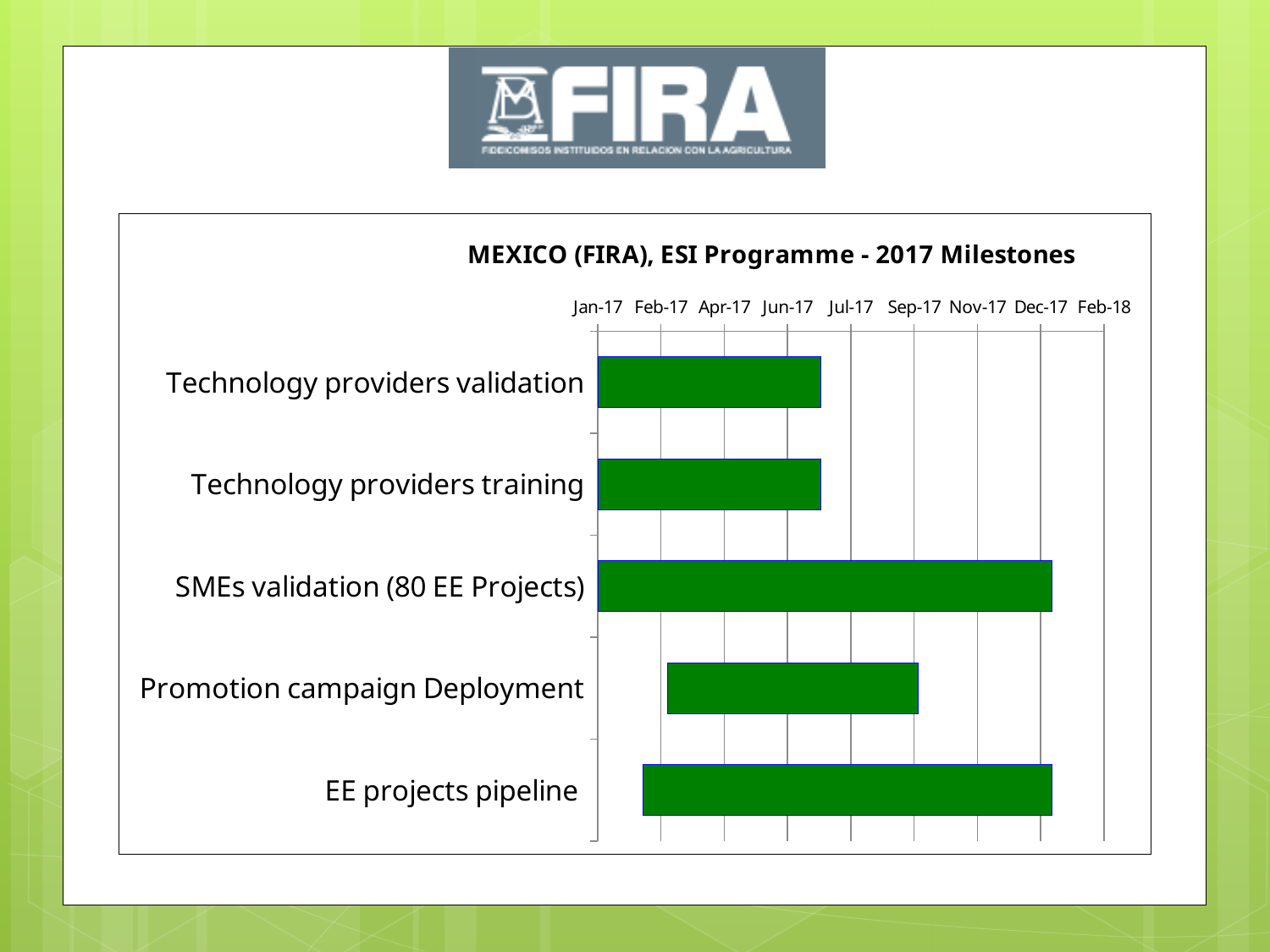
What kind of chart is shown on the slide? Bar chart What colour are the bars in the chart? Green What is the title of the chart? MEXICO (FIRA), ESI Programme - 2017 Milestones Which milestone's bar starts the latest on the time axis? Promotion campaign Deployment Does the bar for SMEs validation (80 EE Projects) extend past Nov-17? Yes What is the last label on the time axis? Feb-18 Does the bar for Technology providers validation end before or after Sep-17? before What is the first label on the time axis? Jan-17 Does the bar for Promotion campaign Deployment start before or after Jan-17? after Which bar is longer: EE projects pipeline or Technology providers training? EE projects pipeline How many milestone categories are plotted in the chart? 5 Which bar is longer: SMEs validation (80 EE Projects) or Promotion campaign Deployment? SMEs validation (80 EE Projects)